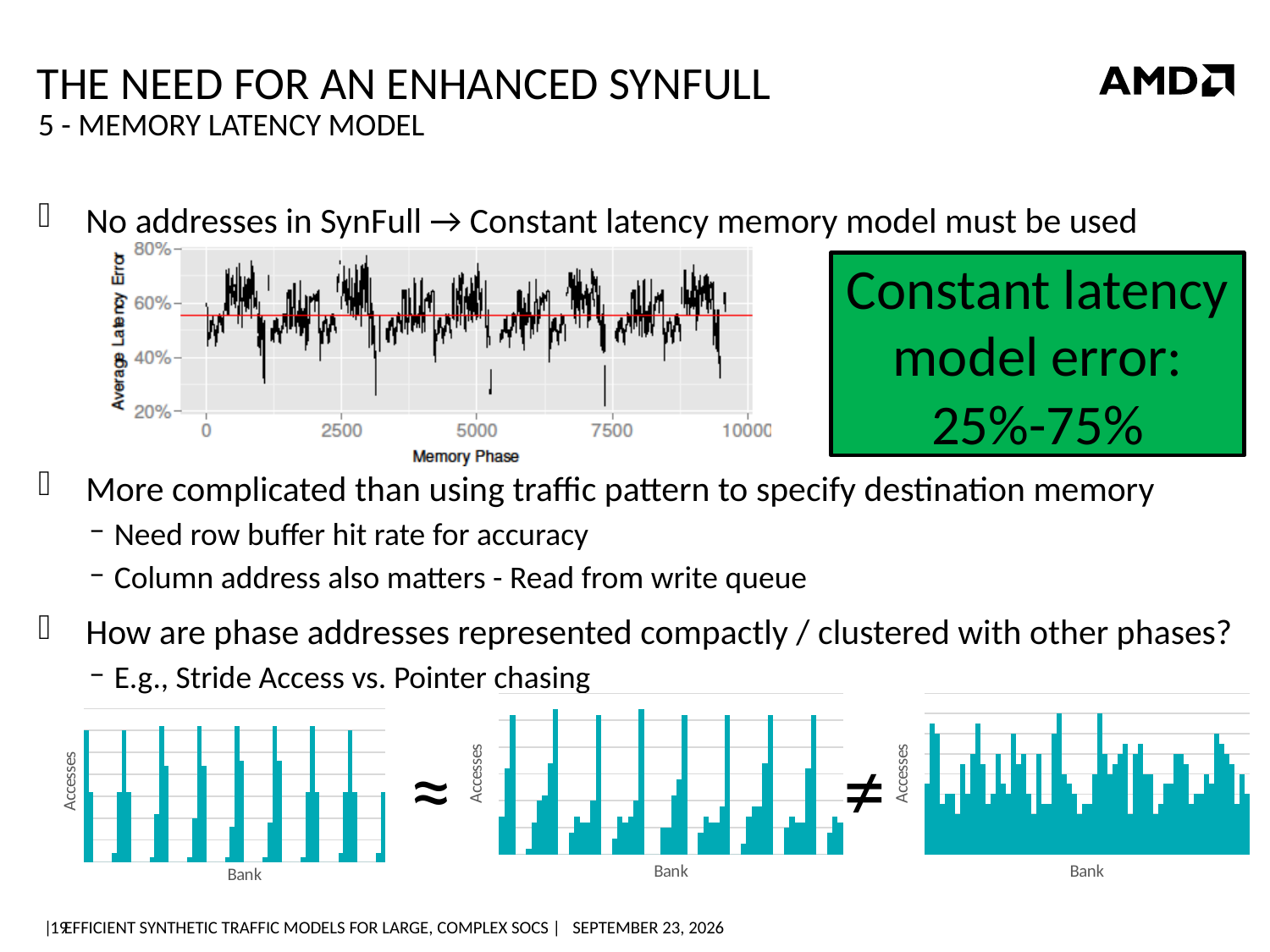
In the top chart of Average Latency Error versus Memory Phase, is the red horizontal line greater or less than 40%? greater What kind of chart is the bottom-right chart with Accesses on the y axis and Bank on the x axis? bar chart What kind of chart is the bottom-left chart with Accesses on the y axis and Bank on the x axis? bar chart How many charts are shown on the slide in total? 4 What kind of chart is the top chart plotting Average Latency Error against Memory Phase? line chart In the top chart of Average Latency Error versus Memory Phase, is the red horizontal line greater or less than 60%? less In the top chart of Average Latency Error versus Memory Phase, what is the largest tick value shown on the x axis? 10000 In the top chart of Average Latency Error versus Memory Phase, what is the highest value shown on the y axis? 80% How many bar charts with Accesses on the y axis and Bank on the x axis are shown at the bottom of the slide? 3